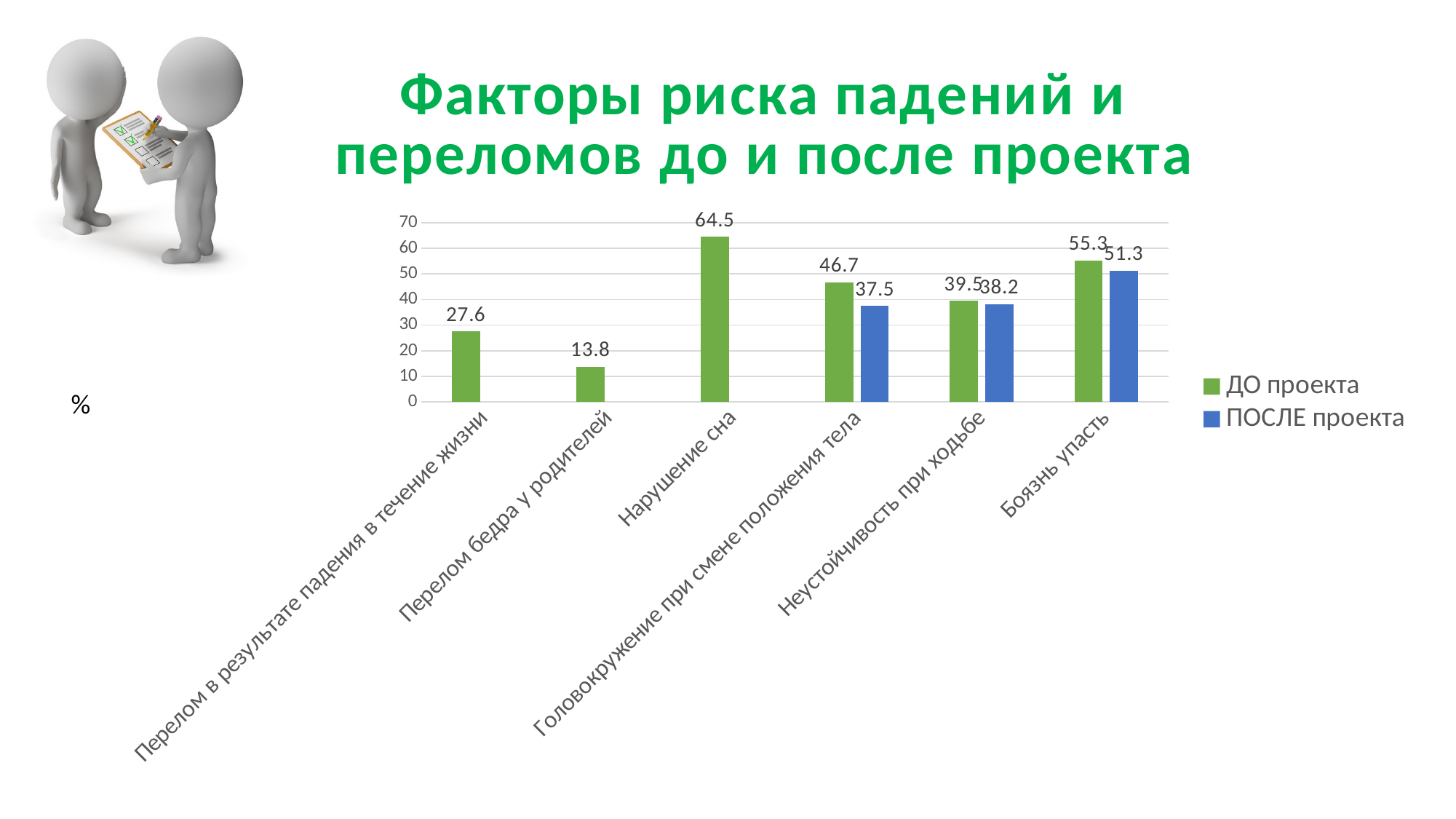
How many categories are shown on the x axis? 6 What is the value for 'Нарушение сна' in the 'ДО проекта' series? 64.5 What type of chart is shown on the slide? bar chart What colour are the bars for the 'ПОСЛЕ проекта' series? blue What is the value for 'Перелом бедра у родителей' in the 'ДО проекта' series? 13.8 Is the 'ДО проекта' value for 'Перелом в результате падения в течение жизни' greater or less than 30? less How many series does the legend list? 2 What is the value for 'Головокружение при смене положения тела' in the 'ПОСЛЕ проекта' series? 37.5 What is the difference between the 'ДО проекта' and 'ПОСЛЕ проекта' values for 'Боязнь упасть'? 4 Which is larger for 'Головокружение при смене положения тела': the 'ДО проекта' value or the 'ПОСЛЕ проекта' value? ДО проекта Which category has the highest value in the 'ДО проекта' series? Нарушение сна Which category has the lowest value in the 'ДО проекта' series? Перелом бедра у родителей